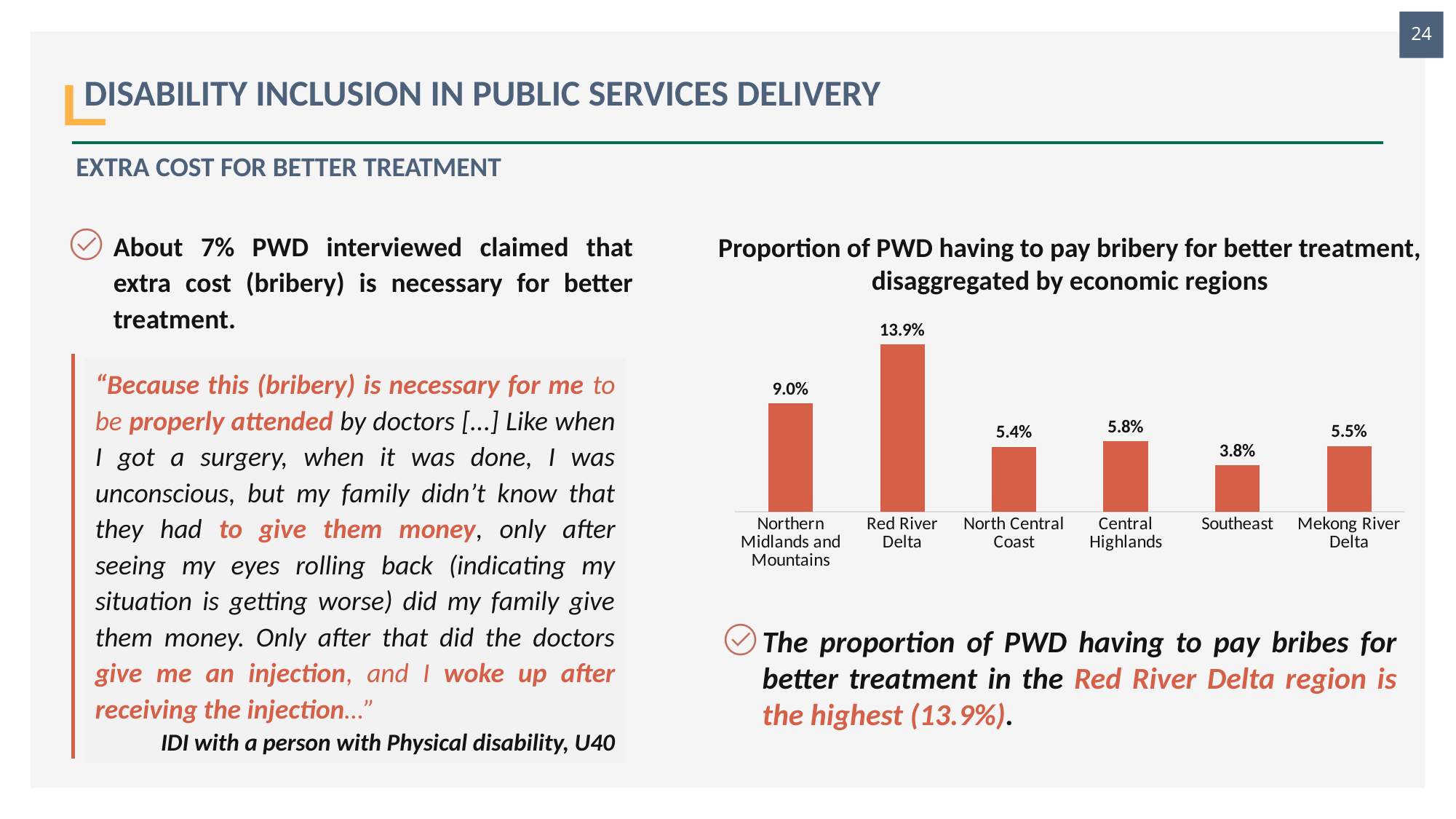
Which region has a larger value, North Central Coast or Central Highlands? Central Highlands What is the value shown for the Southeast region? 3.8% What is the proportion of PWD having to pay bribery for better treatment in the Red River Delta? 13.9% Which region has the highest proportion of PWD having to pay bribery for better treatment? Red River Delta Which region has the lowest proportion of PWD having to pay bribery for better treatment? Southeast What is the value shown for the Mekong River Delta? 5.5% What kind of chart is used to show the proportion of PWD having to pay bribery by economic region? Bar chart How many economic regions are shown in the chart? 6 What is the title of the chart on the slide? Proportion of PWD having to pay bribery for better treatment, disaggregated by economic regions What is the difference between the values for the Central Highlands and the Southeast? 2.0% What is the value shown for the Northern Midlands and Mountains region? 9.0% What is the difference between the values for the Red River Delta and the Northern Midlands and Mountains? 4.9%